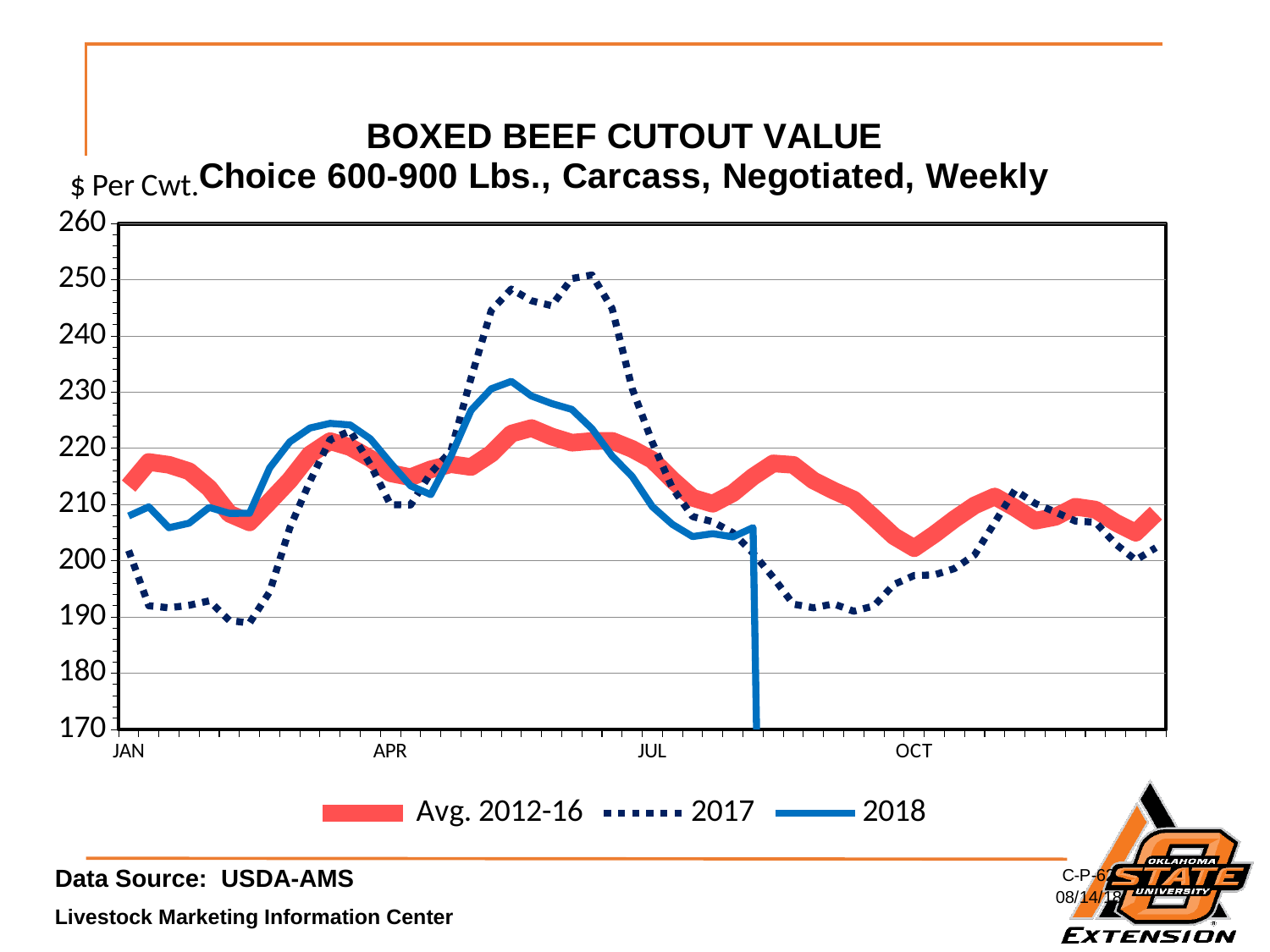
Which series reaches the highest value on the chart? 2017 How many series does the legend list? 3 Is the 2017 value in mid-September greater or less than 200? less Is the 2018 value at the start of January greater or less than 200? greater In early February, which is higher, the 2017 line or the 2018 line? 2018 Is the peak value of the 2017 line greater or less than 240? greater Does the 2017 line rise or fall from April to June? rise In mid-June, which is higher, the 2017 line or the Avg. 2012-16 line? 2017 What are the three series named in the legend? Avg. 2012-16, 2017, 2018 What type of chart is shown on the slide? line chart What is the label on the vertical axis? $ Per Cwt.